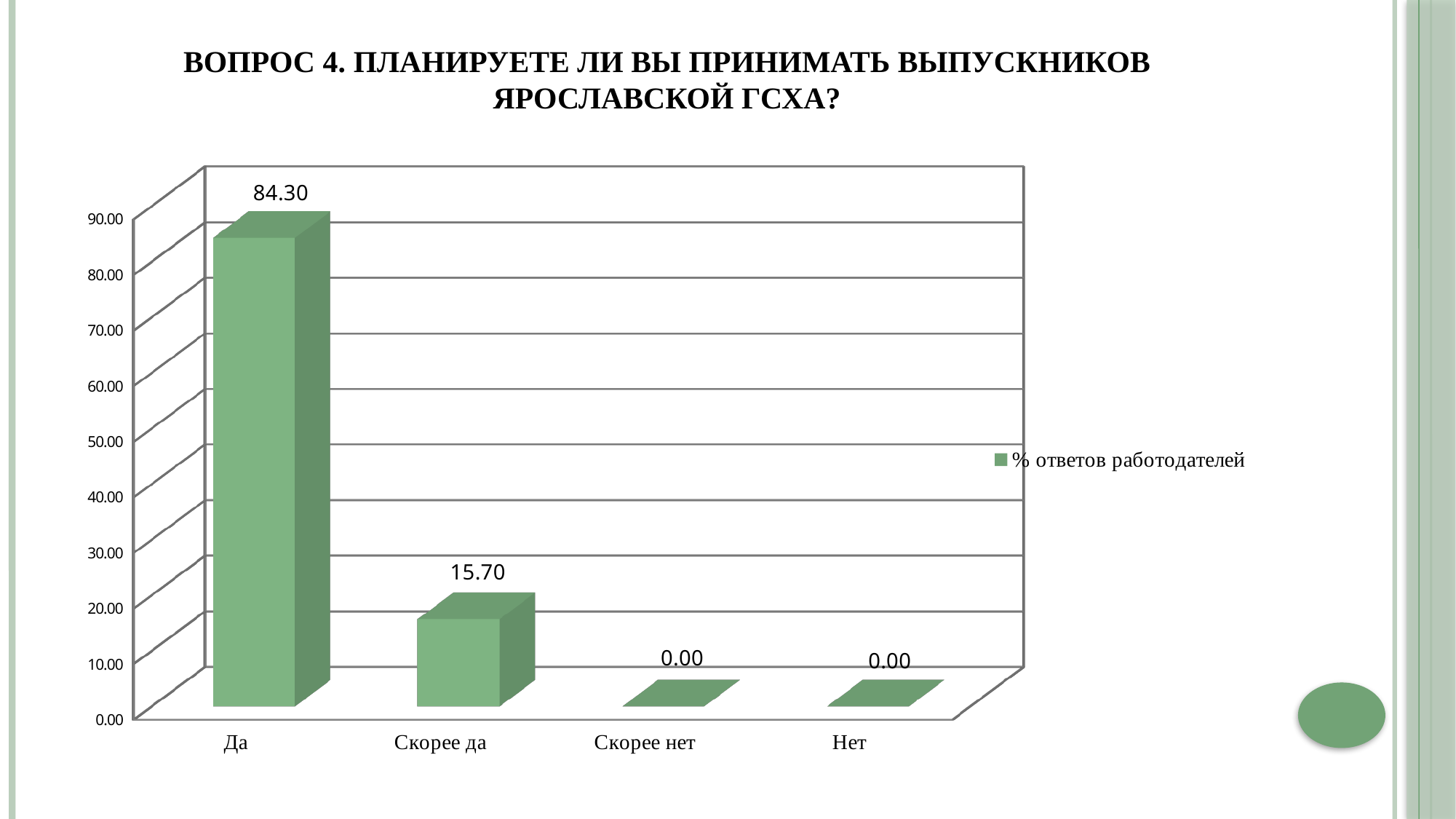
What is the difference between the values for "Да" and "Скорее да"? 68.60 Which is larger, the value for "Да" or the value for "Скорее да"? Да What is the value for "Скорее нет"? 0.00 What is the value for "Нет"? 0.00 Is the value for "Да" greater or less than 80.00? greater How many series does the legend list? 1 Which category has the highest value? Да What is the value for "Скорее да"? 15.70 What is the legend entry for the series? % ответов работодателей What kind of chart is shown on the slide? bar chart What is the value for "Да"? 84.30 How many categories are shown on the x axis? 4